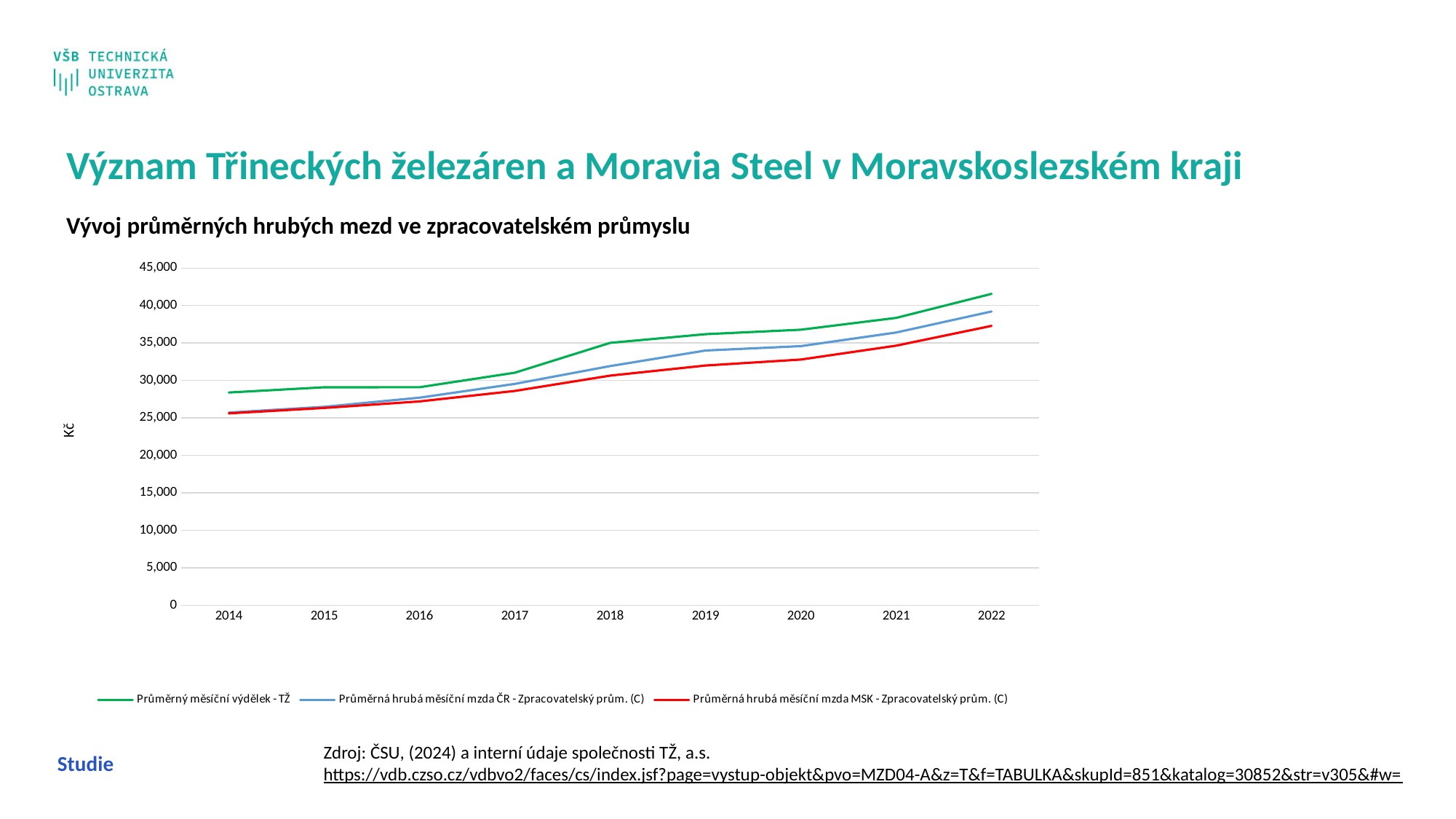
Do the values for Průměrný měsíční výdělek - TŽ rise or fall from 2014 to 2022? rise What is the title of the chart? Vývoj průměrných hrubých mezd ve zpracovatelském průmyslu In 2018, which is larger: Průměrný měsíční výdělek - TŽ or Průměrná hrubá měsíční mzda ČR - Zpracovatelský prům. (C)? Průměrný měsíční výdělek - TŽ How many series does the legend list? 3 Which series has the highest value in 2022? Průměrný měsíční výdělek - TŽ Is the value for Průměrný měsíční výdělek - TŽ in 2014 greater or less than 30,000? less What is the label on the y axis? Kč Is the value for Průměrná hrubá měsíční mzda MSK - Zpracovatelský prům. (C) in 2022 greater or less than 35,000? greater What kind of chart is shown on the slide? line chart Is the value for Průměrný měsíční výdělek - TŽ in 2022 greater or less than 40,000? greater How many years are plotted along the x axis? 9 Which series has the lowest value in 2022? Průměrná hrubá měsíční mzda MSK - Zpracovatelský prům. (C)